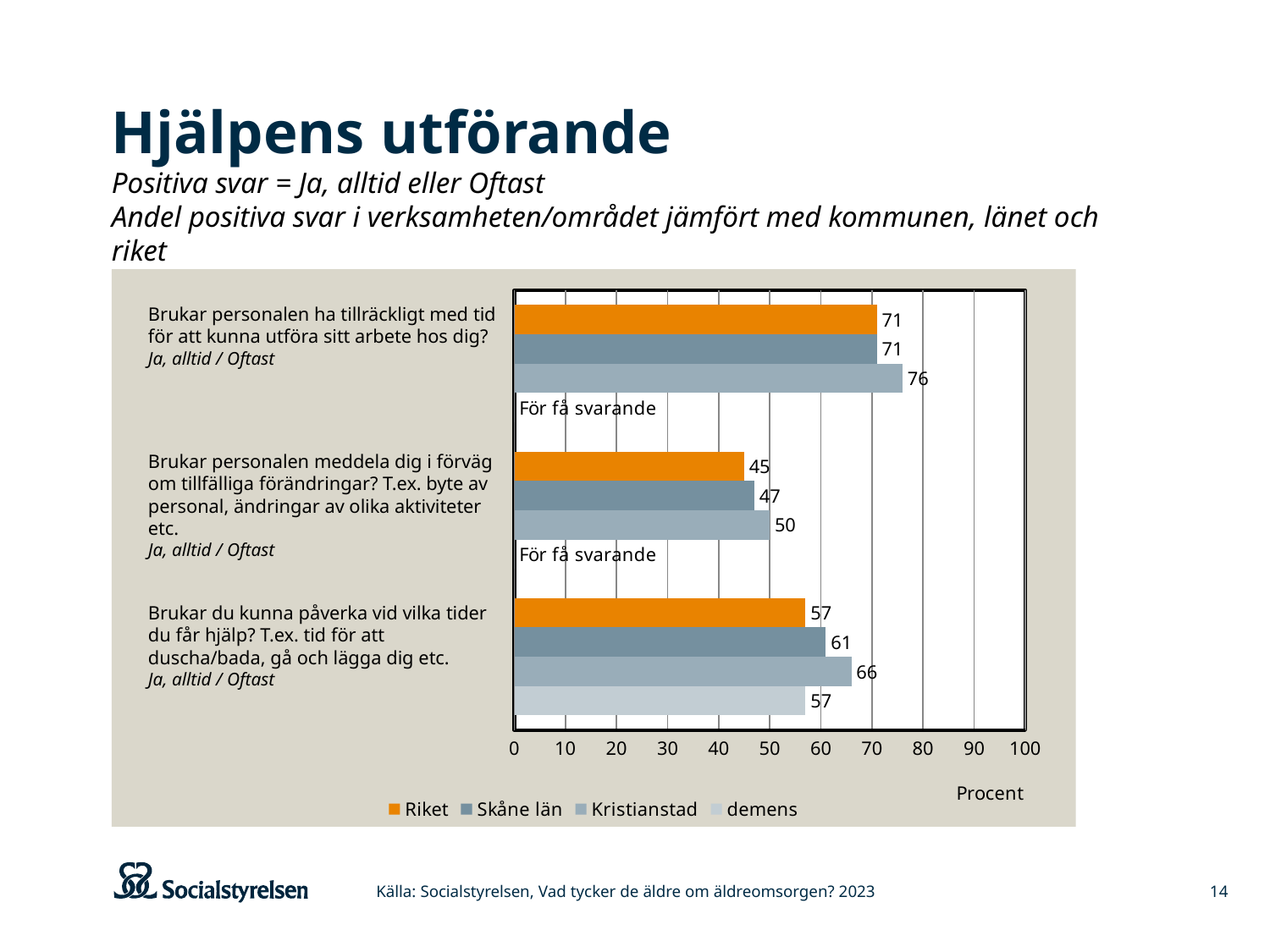
Is the value for Kristianstad for "Brukar personalen ha tillräckligt med tid för att kunna utföra sitt arbete hos dig?" greater or less than 70? greater Which series has the lowest value for "Brukar personalen meddela dig i förväg om tillfälliga förändringar?"? Riket How many series does the legend list? 4 What is the difference between Kristianstad and Riket for "Brukar du kunna påverka vid vilka tider du får hjälp?"? 9 What unit label is shown below the x axis of the chart? Procent What kind of chart is shown on the slide? Bar chart Which is larger for "Brukar personalen meddela dig i förväg om tillfälliga förändringar?": Skåne län or Kristianstad? Kristianstad Which series has the highest value for "Brukar du kunna påverka vid vilka tider du får hjälp?"? Kristianstad What value does Kristianstad have for "Brukar personalen ha tillräckligt med tid för att kunna utföra sitt arbete hos dig?"? 76 What is shown for the demens series for "Brukar personalen ha tillräckligt med tid för att kunna utföra sitt arbete hos dig?"? För få svarande What value does the demens series have for "Brukar du kunna påverka vid vilka tider du får hjälp?"? 57 What value does Riket have for "Brukar personalen meddela dig i förväg om tillfälliga förändringar?"? 45